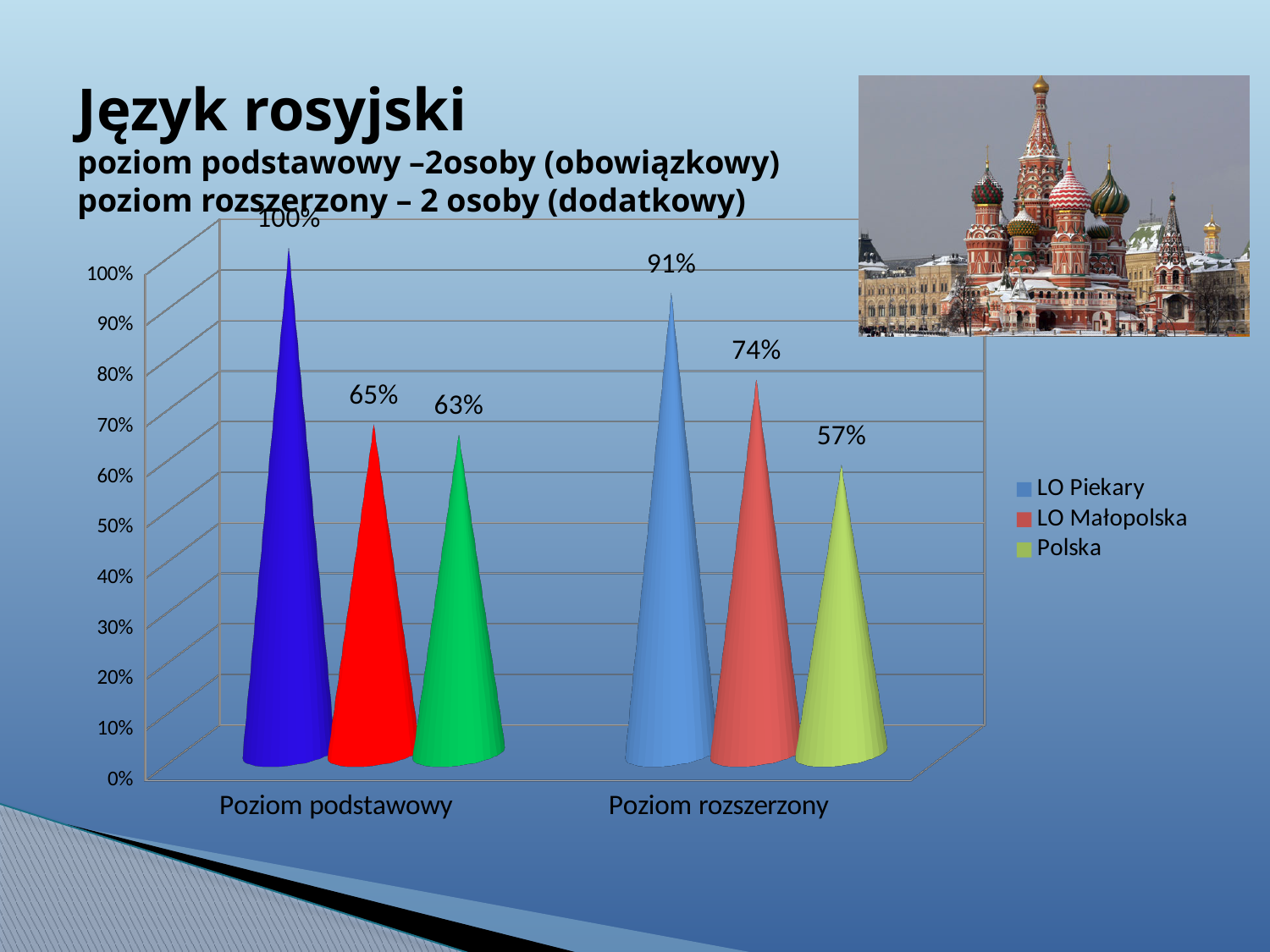
What is the value for Polska at Poziom podstawowy? 63% What kind of chart is shown on the slide? bar chart What is the difference between LO Piekary and Polska at Poziom rozszerzony? 34% How many series does the legend list? 3 How many categories are shown on the x axis? 2 Which series has the highest value at Poziom rozszerzony? LO Piekary Which is larger: LO Małopolska at Poziom podstawowy or LO Małopolska at Poziom rozszerzony? Poziom rozszerzony What is the value for LO Małopolska at Poziom rozszerzony? 74% What is the value for LO Piekary at Poziom podstawowy? 100% Which series has the lowest value at Poziom podstawowy? Polska What is the value for LO Piekary at Poziom rozszerzony? 91% What is the difference between LO Piekary and LO Małopolska at Poziom podstawowy? 35%